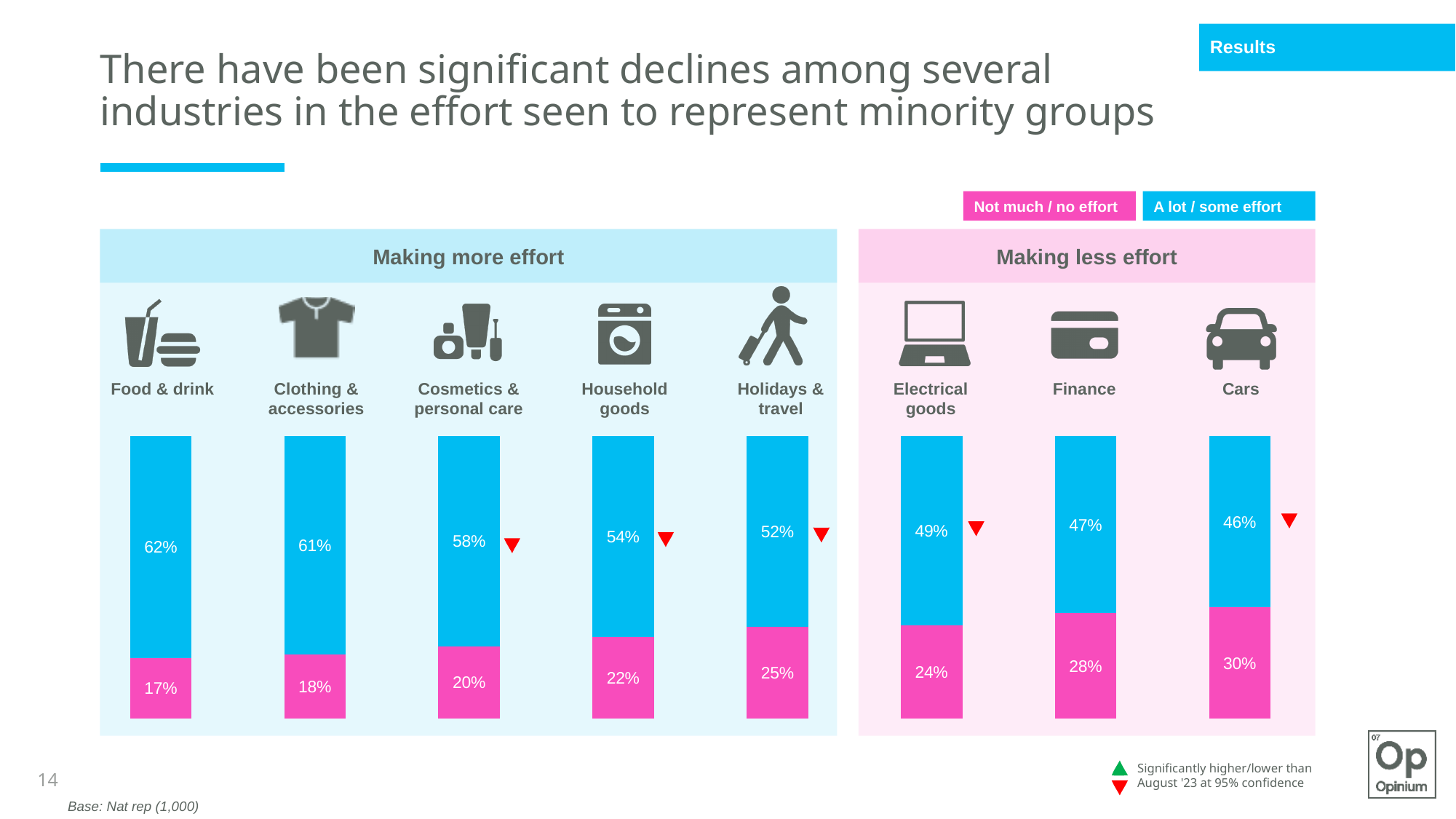
How many series does the legend list? 2 What is the 'Not much / no effort' value for Cars? 30% Which industry has the highest 'A lot / some effort' value? Food & drink Do the 'A lot / some effort' values rise or fall from left to right across the industries? Fall Which industry has the highest 'Not much / no effort' value? Cars Which industry has the lowest 'A lot / some effort' value? Cars What percentage of respondents say the Food & drink industry is making a lot / some effort? 62% What kind of chart is shown on the slide? Stacked bar chart What is the difference between the 'A lot / some effort' values for Food & drink and Cars? 16 percentage points Which has the larger 'Not much / no effort' value, Finance or Electrical goods? Finance What is the combined total of the two segments for the Food & drink bar? 79% How many industries are shown in the chart? 8